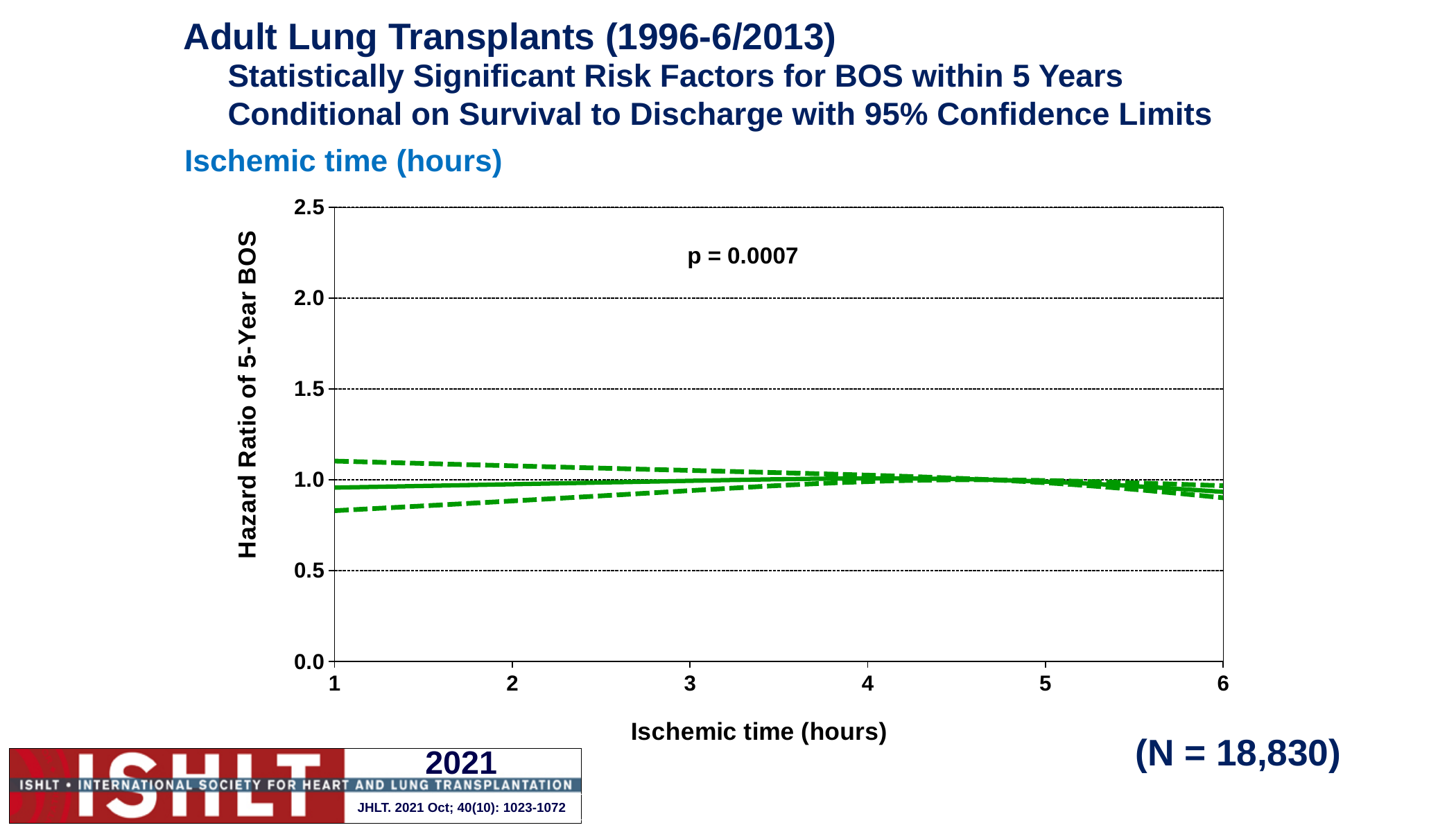
Is the hazard ratio at an ischemic time of 3 hours greater or less than 1.5? less Is the lower confidence limit (lower dashed line) at an ischemic time of 1 hour greater or less than 1.0? less What is the highest value shown on the y-axis of the chart? 2.5 Is the upper confidence limit (upper dashed line) at an ischemic time of 1 hour greater or less than 1.0? greater What is the label of the y-axis of the chart? Hazard Ratio of 5-Year BOS What is the sample size (N) shown on the slide? 18,830 What kind of chart is shown on the slide? line chart How many lines are plotted on the chart? 3 What range of ischemic time (hours) does the x-axis cover? 1 to 6 What is the p-value printed on the chart? p = 0.0007